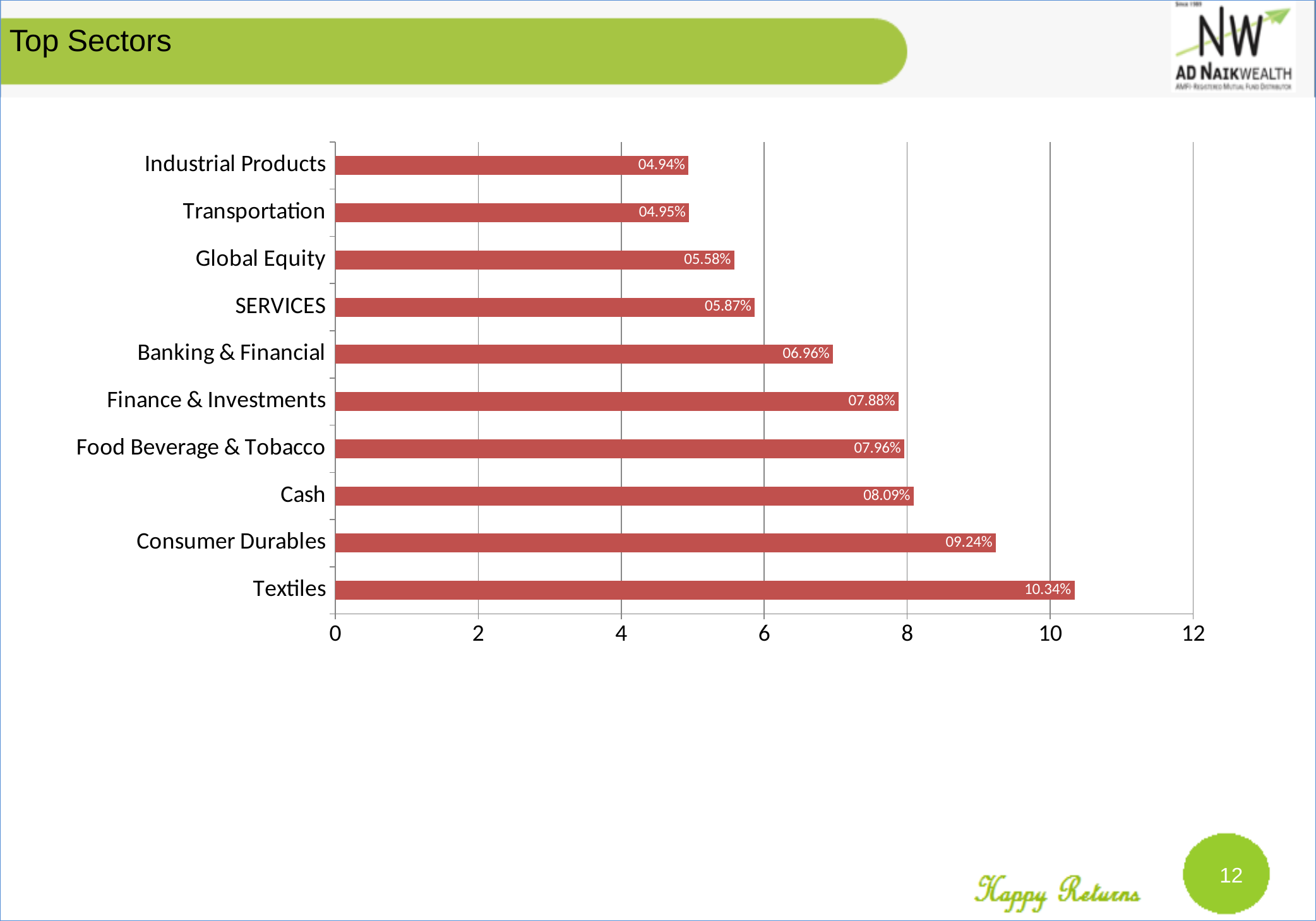
What is the value for Textiles? 10.34% What kind of chart is shown on the slide? bar chart What is the value for Global Equity? 05.58% What is the difference between the values for Cash and SERVICES? 2.22% Which sector has the lowest value? Industrial Products What is the difference between the values for Textiles and Consumer Durables? 1.10% Which is larger, the value for Finance & Investments or the value for Banking & Financial? Finance & Investments How many sectors are shown in the chart? 10 Which sector has the highest value? Textiles What is the value for Banking & Financial? 06.96% What is the title of the slide containing the chart? Top Sectors Is the value for Consumer Durables greater or less than 8? greater